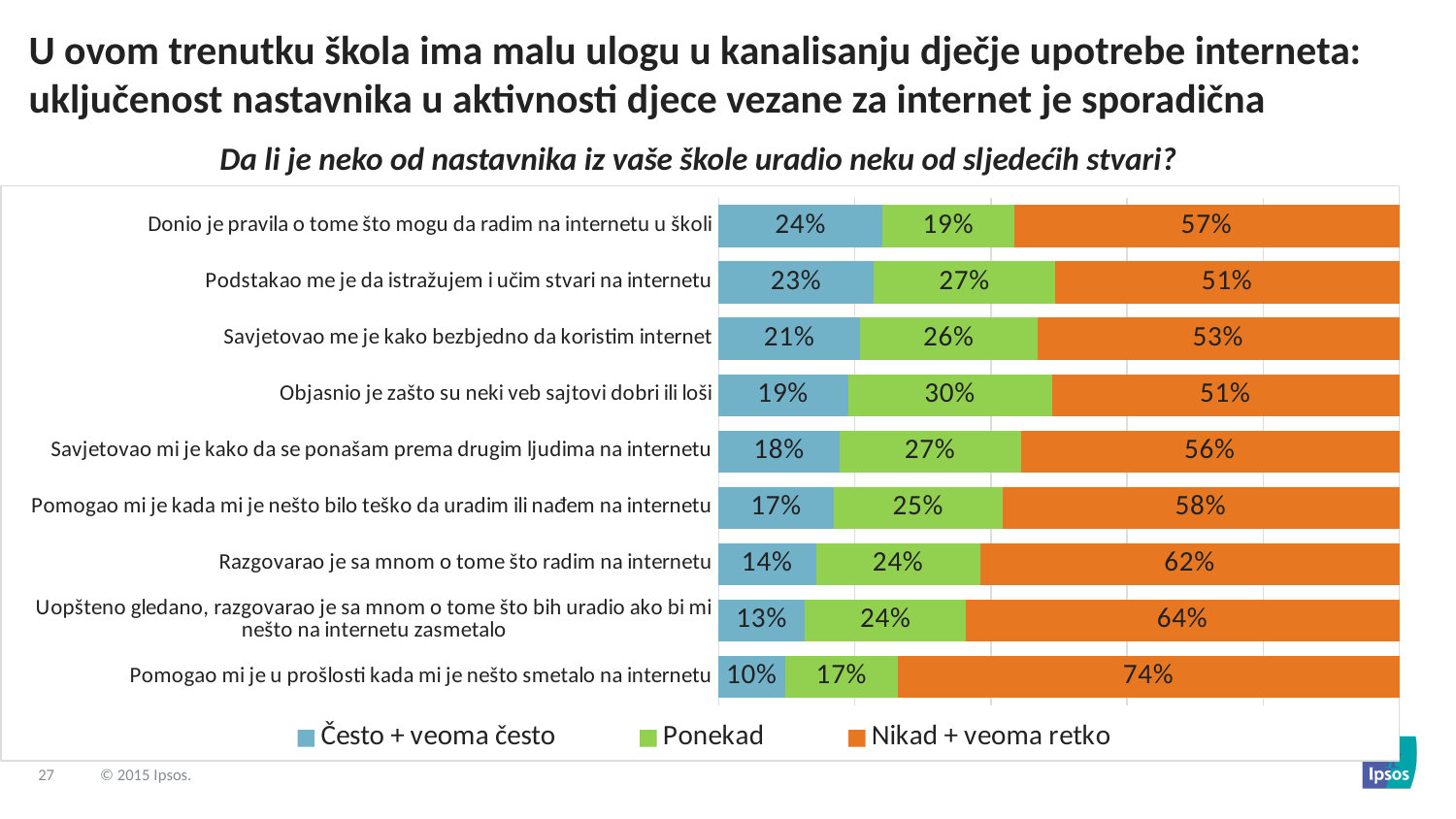
What is the 'Nikad + veoma retko' value for 'Pomogao mi je u prošlosti kada mi je nešto smetalo na internetu'? 74% What is the 'Ponekad' value for 'Objasnio je zašto su neki veb sajtovi dobri ili loši'? 30% What is the difference between the 'Nikad + veoma retko' values for 'Razgovarao je sa mnom o tome što radim na internetu' and 'Podstakao me je da istražujem i učim stvari na internetu'? 11% Which statement has the highest 'Nikad + veoma retko' value? Pomogao mi je u prošlosti kada mi je nešto smetalo na internetu Which is larger: the 'Ponekad' value for 'Podstakao me je da istražujem i učim stvari na internetu' or for 'Donio je pravila o tome što mogu da radim na internetu u školi'? Podstakao me je da istražujem i učim stvari na internetu What is the total of the stacked bar for 'Donio je pravila o tome što mogu da radim na internetu u školi'? 100% Which statement has the lowest 'Često + veoma često' value? Pomogao mi je u prošlosti kada mi je nešto smetalo na internetu What is the 'Često + veoma često' value for 'Donio je pravila o tome što mogu da radim na internetu u školi'? 24% Which colour represents the 'Nikad + veoma retko' series in the chart? orange What kind of chart is shown on the slide? stacked bar chart How many categories (statements) are plotted in the chart? 9 How many series does the legend list? 3